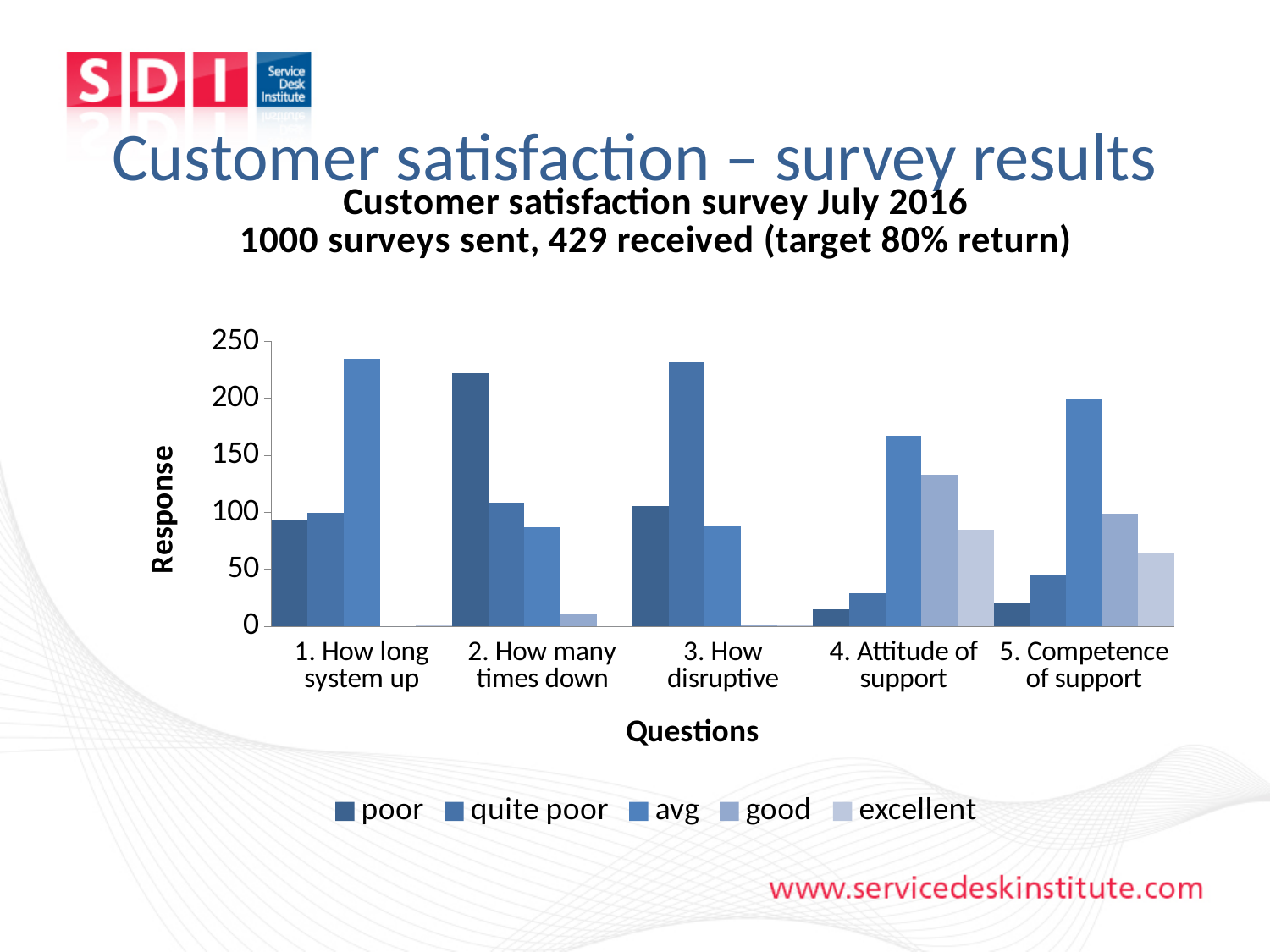
How many question categories are shown on the x axis? 5 What kind of chart is shown on the slide? bar chart How many series does the legend list? 5 For '4. Attitude of support', which is larger: 'avg' or 'good'? avg Which has the larger 'quite poor' value: '2. How many times down' or '5. Competence of support'? 2. How many times down Which question category has the highest 'poor' bar? 2. How many times down Which series has the highest bar for '5. Competence of support'? avg Which series has the lowest bar for '5. Competence of support'? poor Is the 'excellent' value for '4. Attitude of support' greater or less than 100? less Is the 'poor' value for '2. How many times down' greater or less than 200? greater Is the 'avg' value for '1. How long system up' greater or less than 200? greater What is the title of the vertical axis? Response